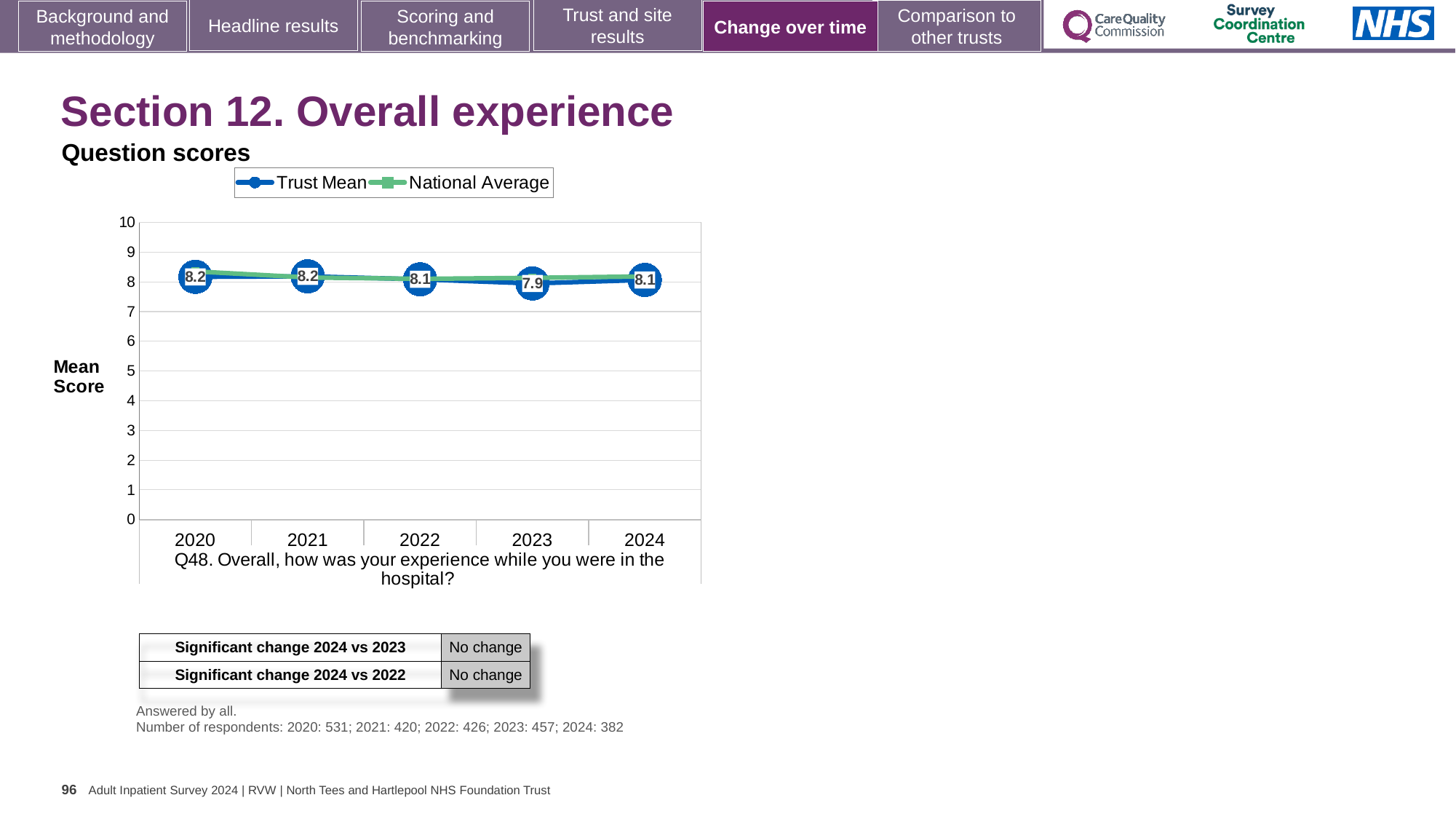
What is the Trust Mean score for 2024? 8.1 In which year is the Trust Mean score lowest? 2023 What is the label on the y axis of the chart? Mean Score What is the Trust Mean score for 2023? 7.9 Is the National Average value for 2022 greater or less than 7? greater What kind of chart is shown? Line chart How many years are plotted on the x axis? 5 How many series does the legend list? 2 Does the Trust Mean score rise or fall from 2020 to 2023? Fall What is the Trust Mean score for 2020? 8.2 What is the difference between the Trust Mean scores for 2020 and 2023? 0.3 Which year has the larger Trust Mean score, 2021 or 2023? 2021